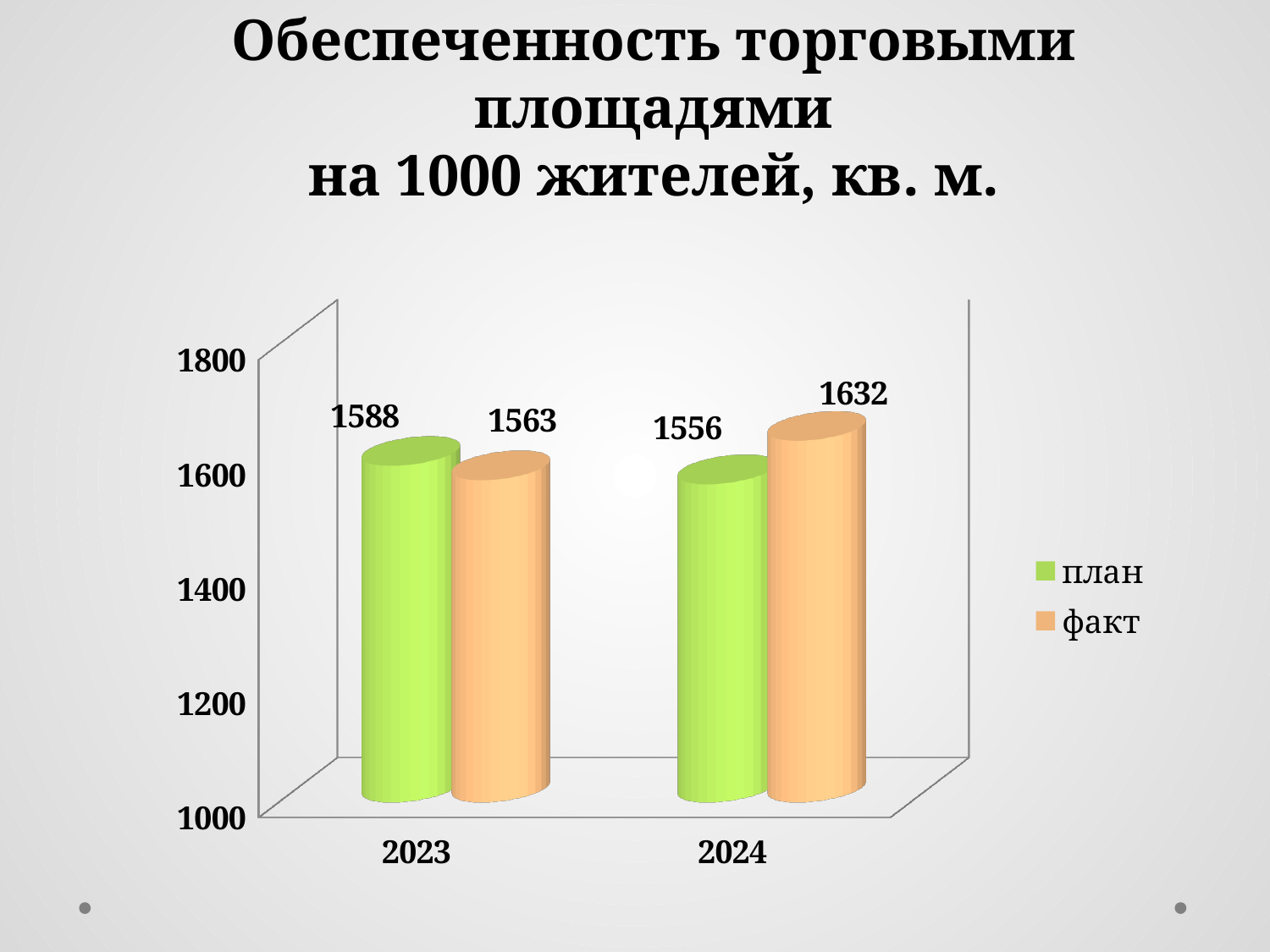
How many series does the legend list? 2 Which year has the highest факт value? 2024 What is the value of факт for 2024? 1632 What is the value of план for 2023? 1588 Which year has the lowest план value? 2024 What is the value of факт for 2023? 1563 What is the difference between факт and план in 2024? 76 Which is larger in 2023, план or факт? план How many years are shown on the x axis? 2 What kind of chart is shown on the slide? bar chart Does the факт value rise or fall from 2023 to 2024? rise What is the value of план for 2024? 1556